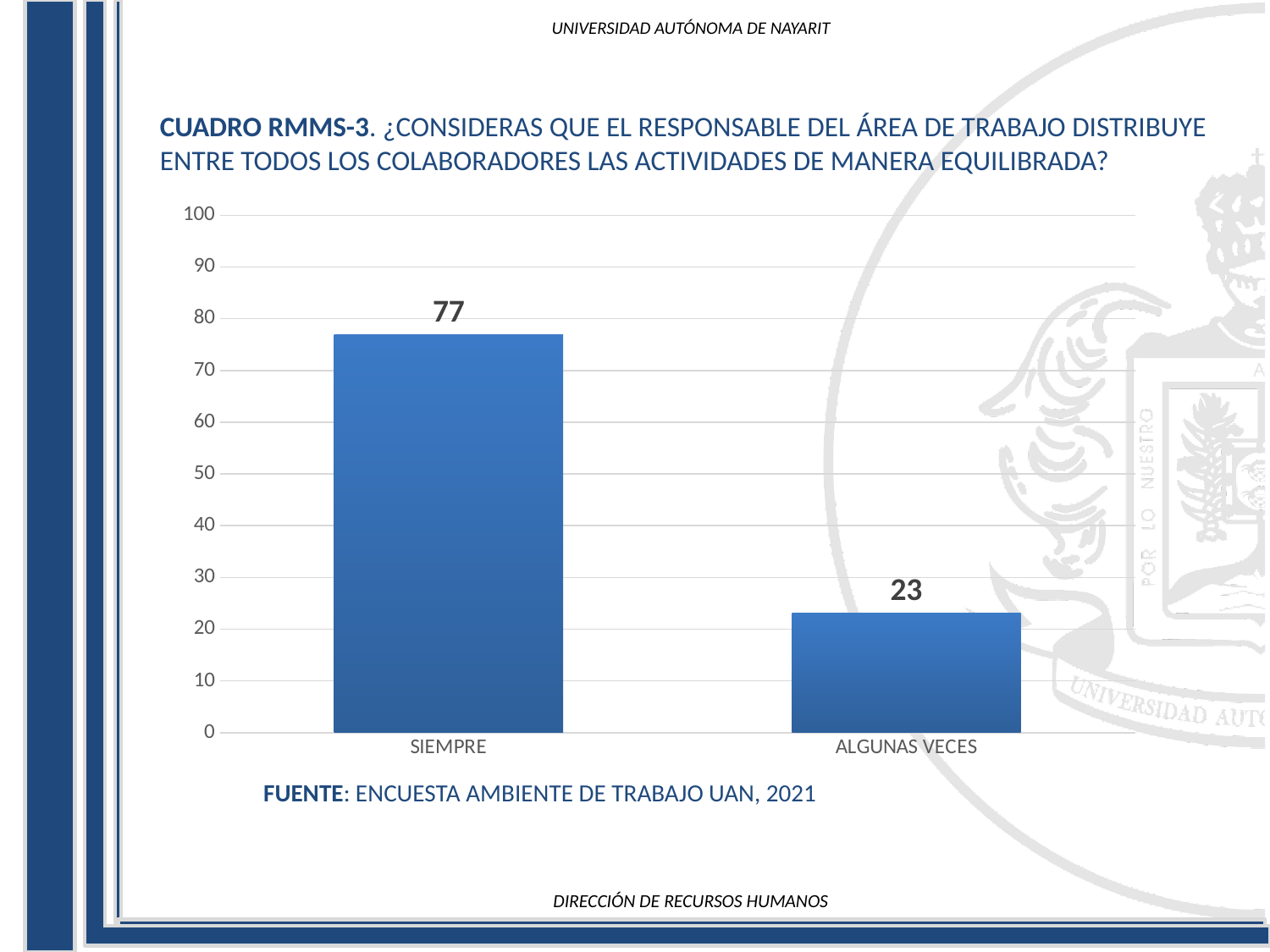
What is the difference between the values for SIEMPRE and ALGUNAS VECES? 54 How many categories are shown on the x axis? 2 What kind of chart is shown on the slide? bar chart What is the value for ALGUNAS VECES? 23 Is the value for ALGUNAS VECES greater or less than 30? less Is the value for SIEMPRE greater or less than 70? greater Which category has the lowest value? ALGUNAS VECES What is the value for SIEMPRE? 77 Which is larger, the value for SIEMPRE or the value for ALGUNAS VECES? SIEMPRE What source is cited below the chart? ENCUESTA AMBIENTE DE TRABAJO UAN, 2021 What is the maximum value shown on the vertical axis? 100 Which category has the highest value? SIEMPRE